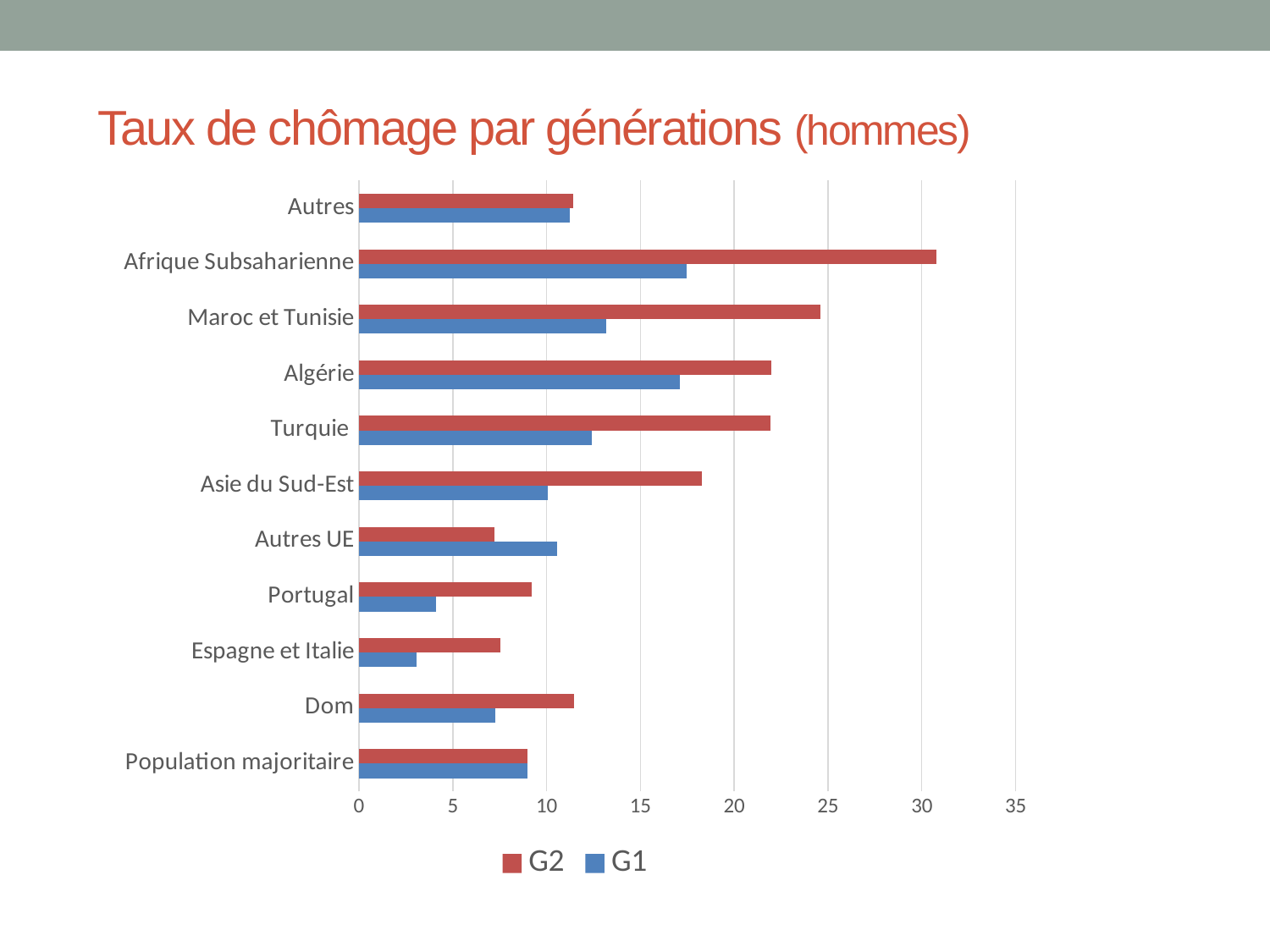
Is the G1 value for Turquie greater or less than 10? greater What is the title of the chart? Taux de chômage par générations (hommes) What kind of chart is shown on the slide? bar chart Which category has the highest G2 value? Afrique Subsaharienne Is the G2 value for Maroc et Tunisie greater or less than 25? less Is the G2 value for Afrique Subsaharienne greater or less than 30? greater Which category has the lowest G1 value? Espagne et Italie How many series does the legend list? 2 Which is larger, the G2 value for Turquie or the G2 value for Asie du Sud-Est? Turquie How many categories are shown on the chart? 11 For Autres UE, which is larger, the G1 value or the G2 value? G1